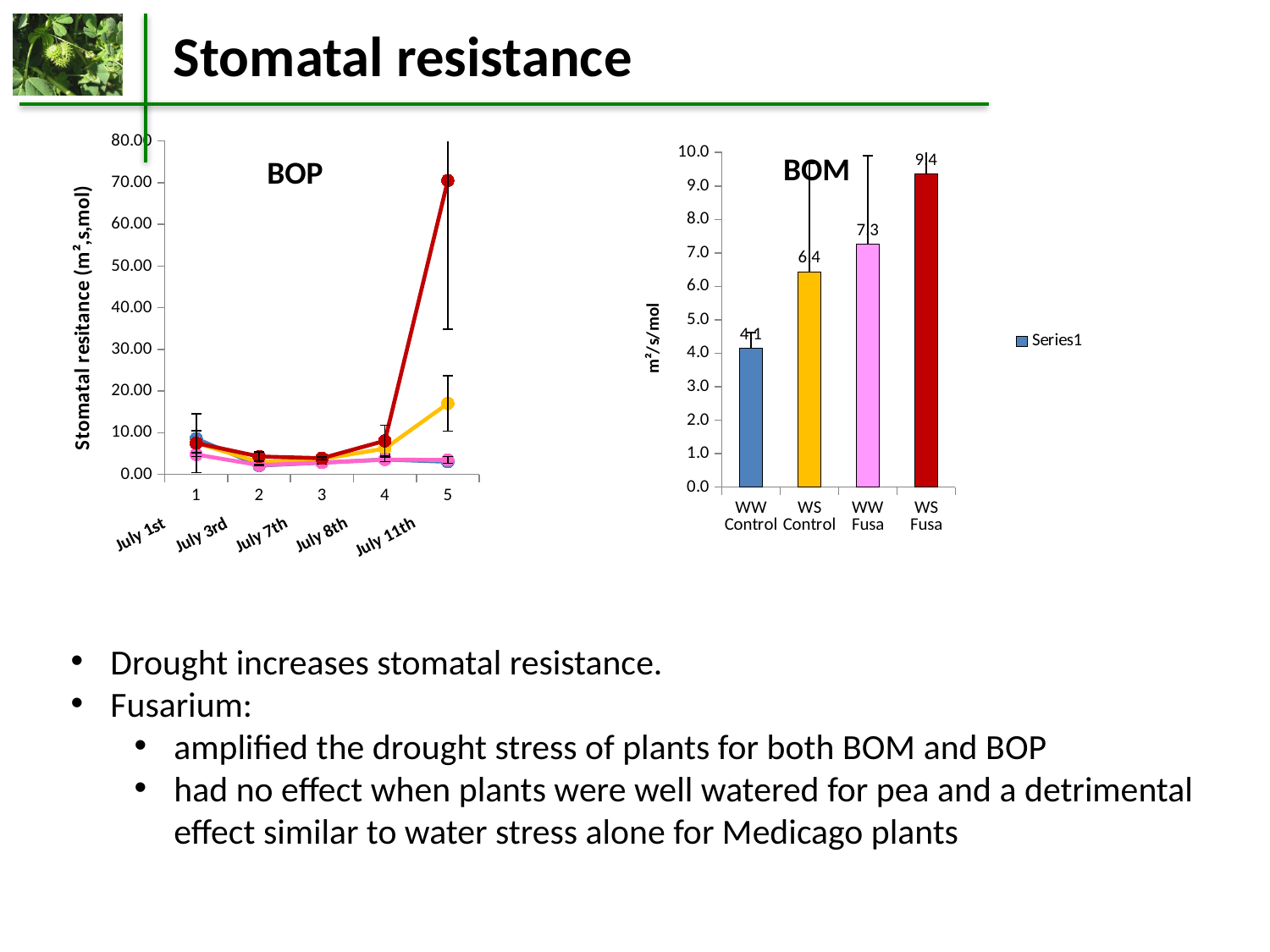
What kind of chart is the BOM chart? bar chart In the BOM chart, what is the difference between the values for WS Fusa and WW Control? 5.3 What entry does the legend of the BOM chart list? Series1 How many bars are shown in the BOM chart? 4 In the BOM chart, which category has the lowest value? WW Control In the BOM chart, which is larger, the value for WS Control or the value for WW Fusa? WW Fusa What kind of chart is the BOP chart? line chart In the BOM chart, what is the value for WS Fusa? 9.4 In the BOM chart, which category has the highest value? WS Fusa In the BOP chart, is the value of the red line at point 5 (July 11th) greater or less than 60? greater In the BOM chart, what is the value for WW Control? 4.1 In the BOM chart, what is the value for WS Control? 6.4